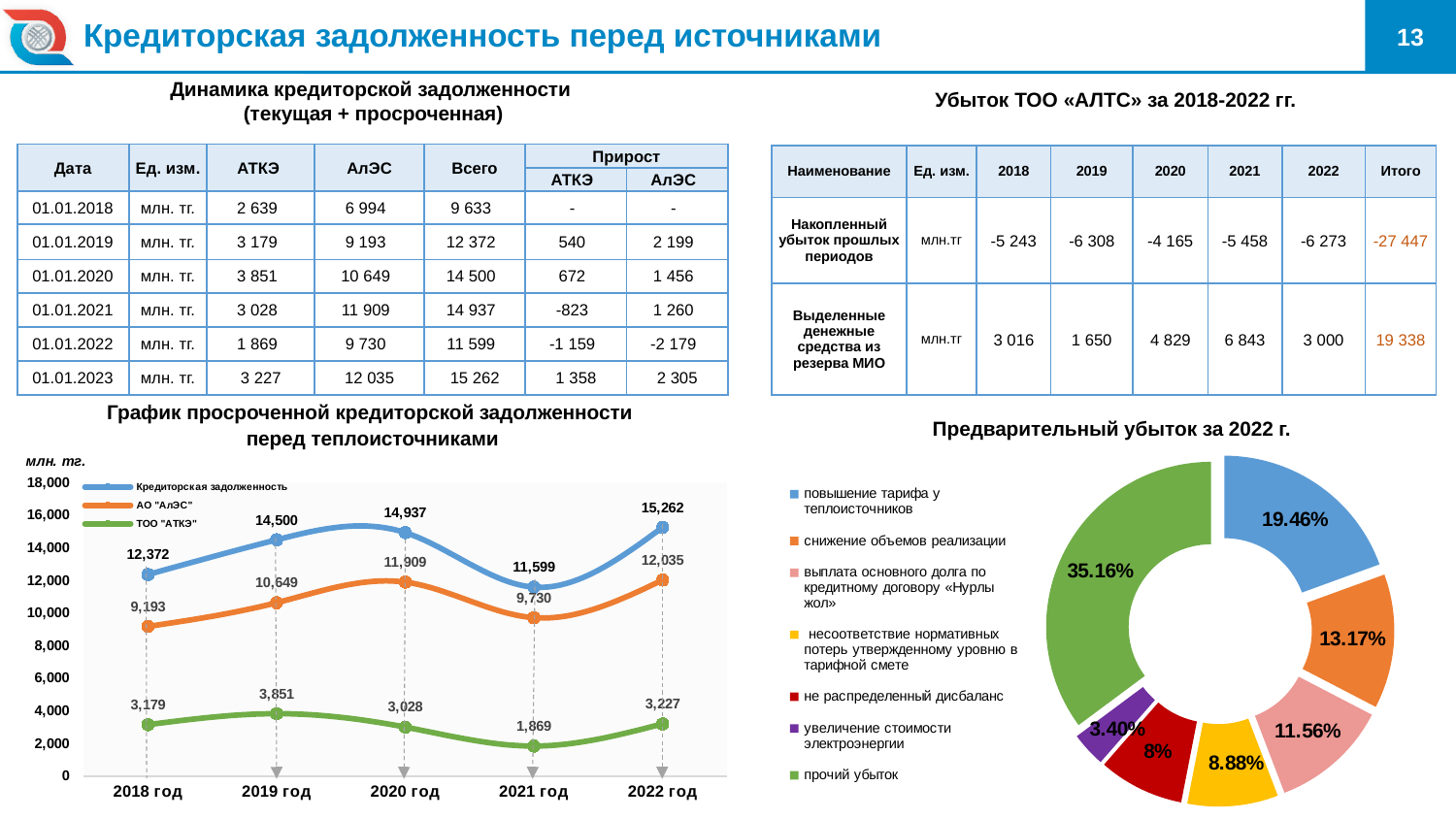
On the line chart 'График просроченной кредиторской задолженности перед теплоисточниками', how many years are shown on the x axis? 5 On the doughnut chart 'Предварительный убыток за 2022 г.', which category has the smallest share? увеличение стоимости электроэнергии On the line chart 'График просроченной кредиторской задолженности перед теплоисточниками', what is the value of 'Кредиторская задолженность' for 2022 год? 15,262 On the line chart 'График просроченной кредиторской задолженности перед теплоисточниками', in which year is the ТОО "АТКЭ" series highest? 2019 год On the doughnut chart 'Предварительный убыток за 2022 г.', what share is shown for 'прочий убыток'? 35.16% On the line chart 'График просроченной кредиторской задолженности перед теплоисточниками', what is the value for АО "АлЭС" in 2020 год? 11,909 On the line chart 'График просроченной кредиторской задолженности перед теплоисточниками', what is the difference between the 'Кредиторская задолженность' values for 2022 год and 2021 год? 3,663 On the line chart 'График просроченной кредиторской задолженности перед теплоисточниками', what is the value for ТОО "АТКЭ" in 2021 год? 1,869 On the line chart 'График просроченной кредиторской задолженности перед теплоисточниками', how many series does the legend list? 3 On the line chart 'График просроченной кредиторской задолженности перед теплоисточниками', in which year is the 'Кредиторская задолженность' series lowest? 2021 год What kind of chart is 'Предварительный убыток за 2022 г.'? Doughnut chart On the doughnut chart 'Предварительный убыток за 2022 г.', which is larger: the share for 'снижение объемов реализации' or for 'выплата основного долга по кредитному договору «Нурлы жол»'? снижение объемов реализации